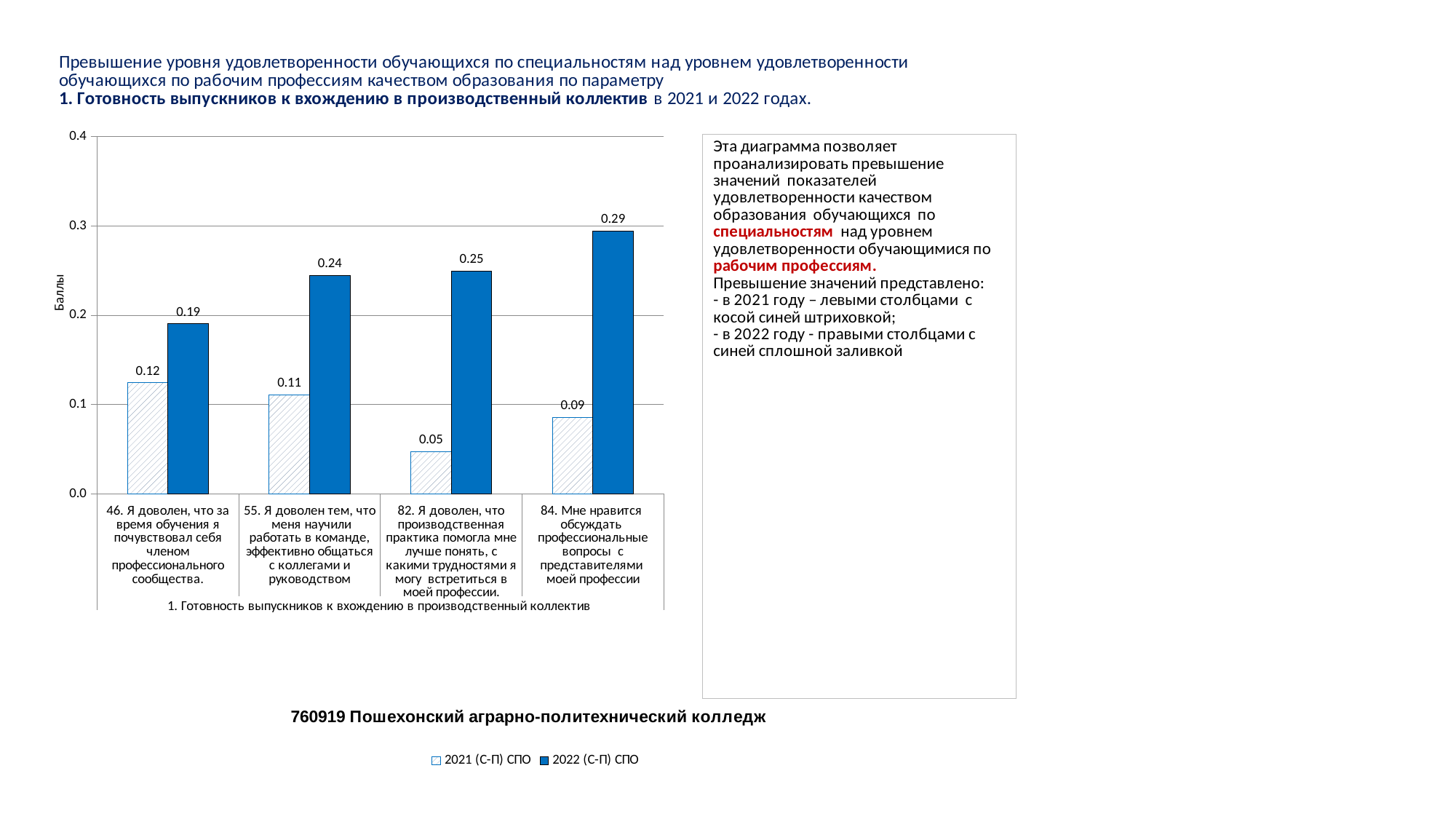
Which is larger for category 46: the 2021 (С-П) СПО value or the 2022 (С-П) СПО value? 2022 (С-П) СПО What is the value of the 2022 (С-П) СПО series for category 84 (Мне нравится обсуждать профессиональные вопросы с представителями моей профессии)? 0.29 What is the label of the vertical axis of the chart? Баллы What is the value of the 2021 (С-П) СПО series for category 46 (Я доволен, что за время обучения я почувствовал себя членом профессионального сообщества)? 0.12 What is the difference between the 2022 (С-П) СПО and 2021 (С-П) СПО values for category 55 (Я доволен тем, что меня научили работать в команде...)? 0.13 What is the value of the 2021 (С-П) СПО series for category 82 (Я доволен, что производственная практика помогла мне лучше понять...)? 0.05 What type of chart is shown on the slide? bar chart Which category has the lowest value in the 2021 (С-П) СПО series? 82. Я доволен, что производственная практика помогла мне лучше понять, с какими трудностями я могу встретиться в моей профессии. Is the 2022 (С-П) СПО value for category 82 greater or less than 0.2? greater How many categories are shown on the x axis of the chart? 4 Which category has the highest value in the 2022 (С-П) СПО series? 84. Мне нравится обсуждать профессиональные вопросы с представителями моей профессии How many series does the chart legend list? 2